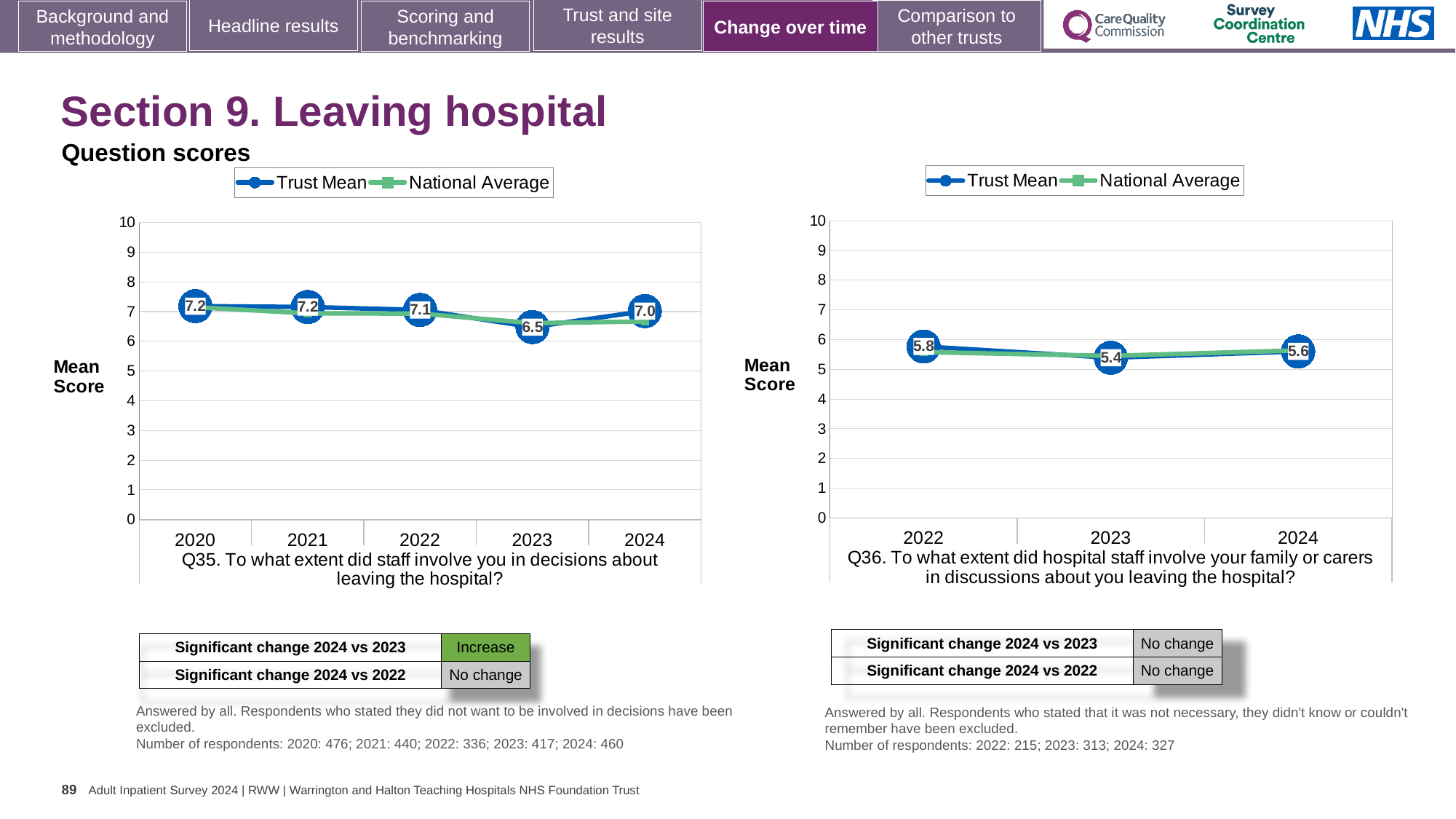
In the Q36 chart on the right, which year has the highest Trust Mean score? 2022 In the Q35 chart on the left, by how much did the Trust Mean score increase from 2023 to 2024? 0.5 In the Q35 chart on the left, which year has the lowest Trust Mean score? 2023 In the Q36 chart on the right, what is the Trust Mean score for 2022? 5.8 In the Q36 chart on the right, what is the difference between the Trust Mean scores for 2022 and 2023? 0.4 What type of chart is used for the Q35 chart on the left? Line chart How many years are plotted in the Q36 chart on the right? 3 In the Q35 chart on the left, what is the Trust Mean score for 2024? 7.0 In the Q35 chart on the left, is the National Average for 2023 greater or less than 7? less In the Q35 chart on the left, is the Trust Mean score higher in 2022 or in 2023? 2022 In the Q35 chart on the left, what is the Trust Mean score for 2023? 6.5 In the Q36 chart on the right, which year has the lowest Trust Mean score? 2023